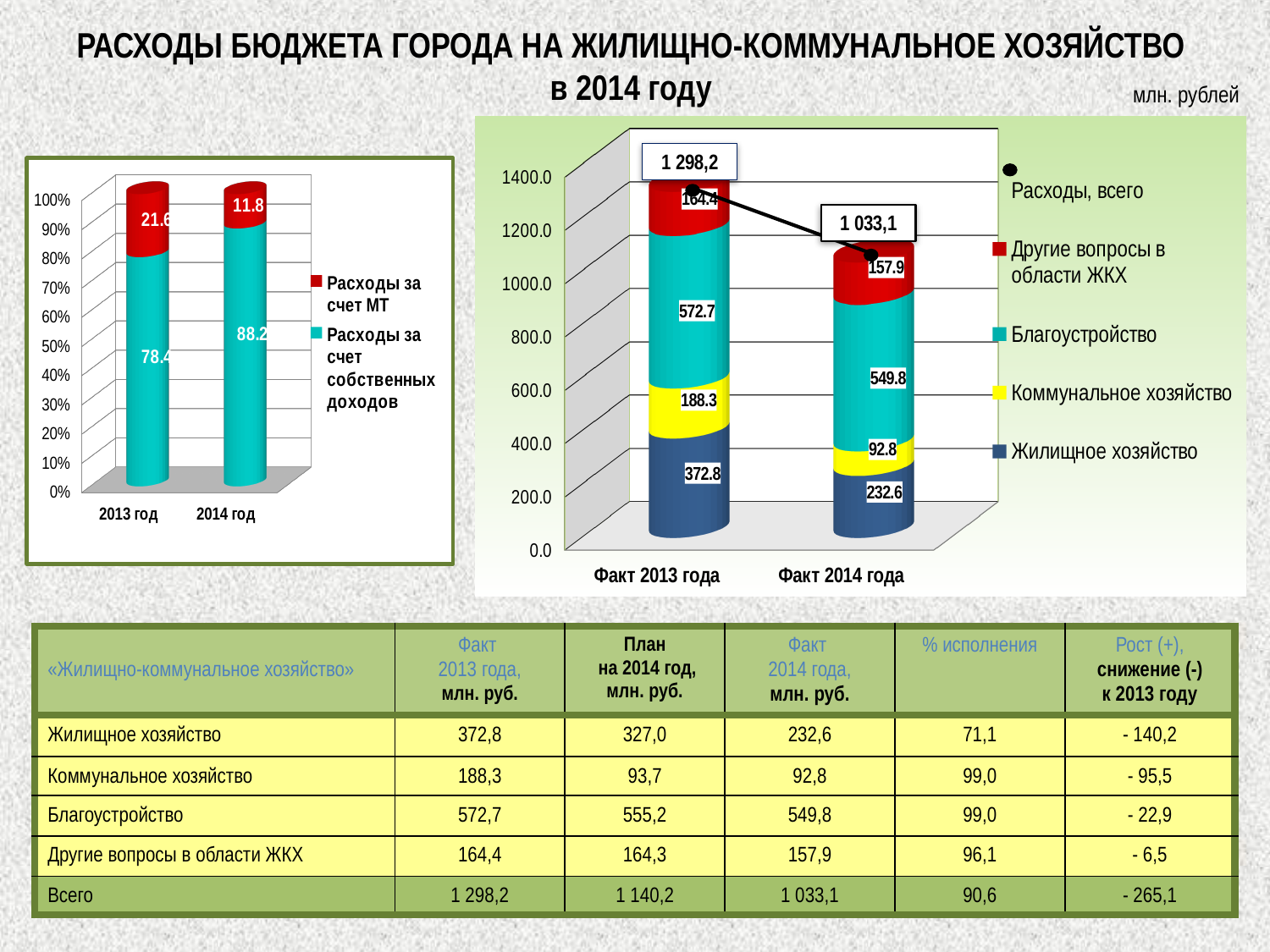
In the right-hand chart, which segment is the smallest in the Факт 2014 года bar? Коммунальное хозяйство In the right-hand chart, what is the value for Благоустройство in Факт 2013 года? 572.7 In the right-hand chart, how many series does the legend list? 5 In the right-hand chart, what is the value for Жилищное хозяйство in Факт 2014 года? 232.6 What kind of chart is the left-hand chart? Stacked bar chart In the right-hand chart, which segment is the largest in the Факт 2013 года bar? Благоустройство In the right-hand chart, what is the total Расходы, всего for Факт 2014 года? 1 033,1 In the right-hand chart, is Коммунальное хозяйство larger in Факт 2013 года or Факт 2014 года? Факт 2013 года In the right-hand chart, what is the difference between Жилищное хозяйство in Факт 2013 года and Факт 2014 года? 140.2 In the left-hand chart, what is the value for Расходы за счет собственных доходов in 2013 год? 78.4 In the left-hand chart, how many categories are shown on the x axis? 2 In the left-hand chart, what is the value for Расходы за счет МТ in 2014 год? 11.8